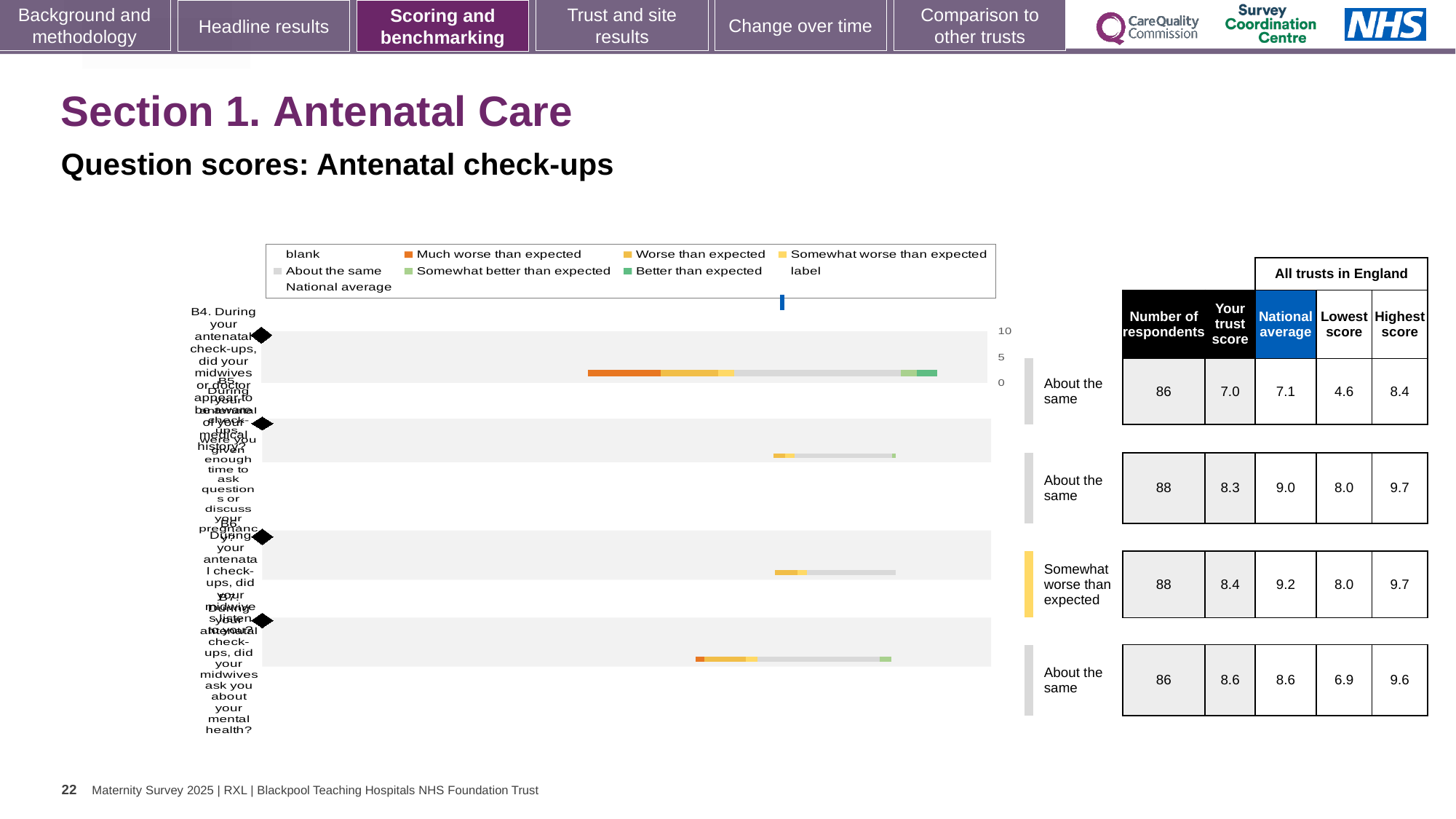
What kind of chart is used to show the question scores for antenatal check-ups? Bar chart What colour represents 'Much worse than expected' in the chart legend? Orange What is the national average for question B5? 9.0 For question B6, which is larger: the trust score or the national average? National average What benchmark category is shown for question B6? Somewhat worse than expected What is the highest score among all trusts in England for question B7? 9.6 How many respondents answered question B6? 88 For question B5, what is the difference between the national average and the trust score? 0.7 Which question has the highest 'Your trust score'? B7 Which question has the lowest national average? B4 What is the 'Your trust score' for question B4? 7.0 How many questions (bars) are plotted in the antenatal check-ups chart? 4